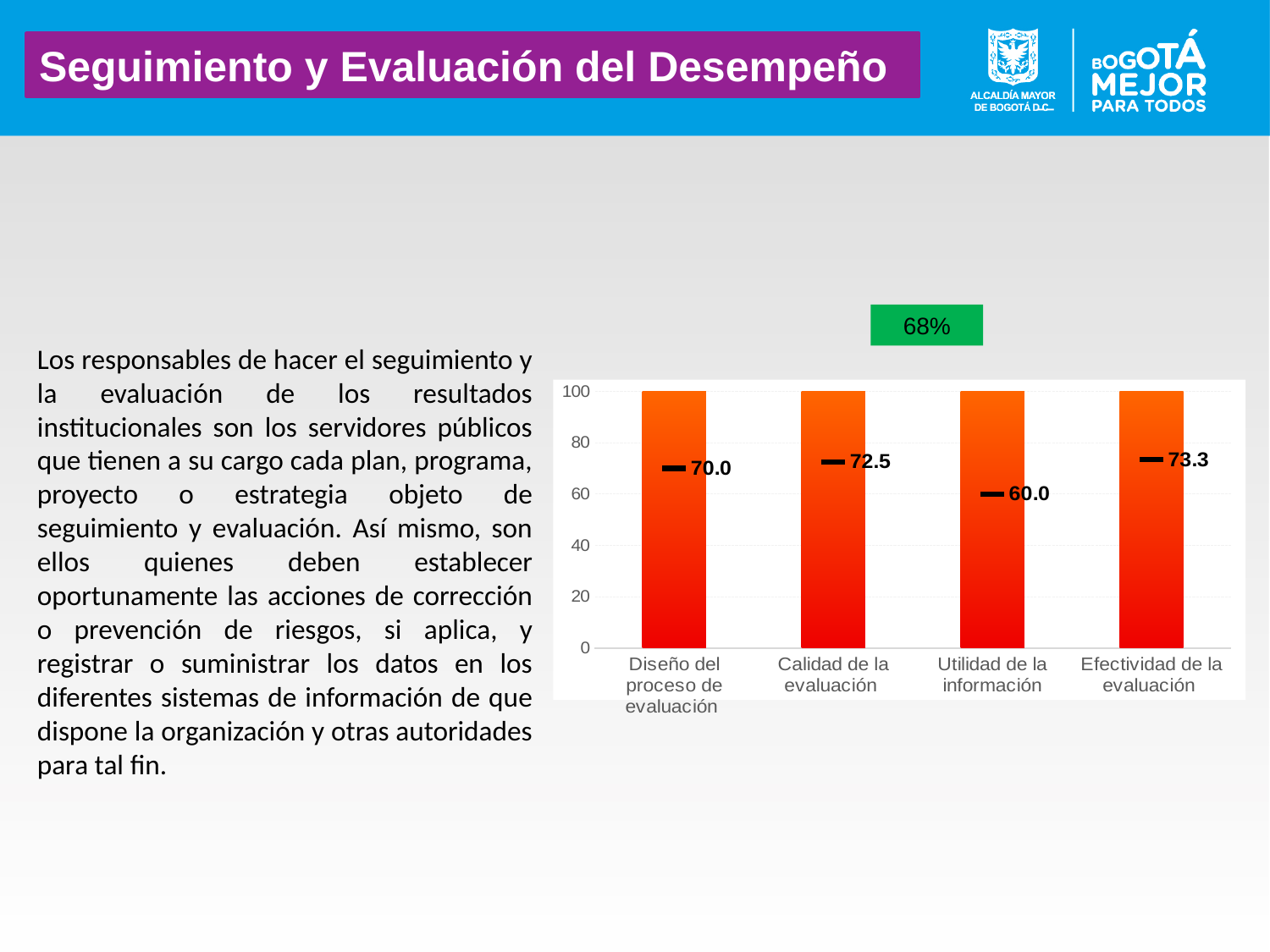
What kind of chart is shown on the slide? bar chart Which has a larger labelled value, "Diseño del proceso de evaluación" or "Calidad de la evaluación"? Calidad de la evaluación Which category has the highest labelled value? Efectividad de la evaluación What is the labelled value for "Diseño del proceso de evaluación"? 70.0 What is the difference between the labelled values for "Calidad de la evaluación" and "Utilidad de la información"? 12.5 Is the labelled value for "Utilidad de la información" greater or less than 80? less What is the labelled value for "Efectividad de la evaluación"? 73.3 What percentage is shown in the green box above the chart? 68% What is the labelled value for "Utilidad de la información"? 60.0 How many categories are shown on the x axis of the chart? 4 Which category has the lowest labelled value? Utilidad de la información What is the labelled value for "Calidad de la evaluación"? 72.5